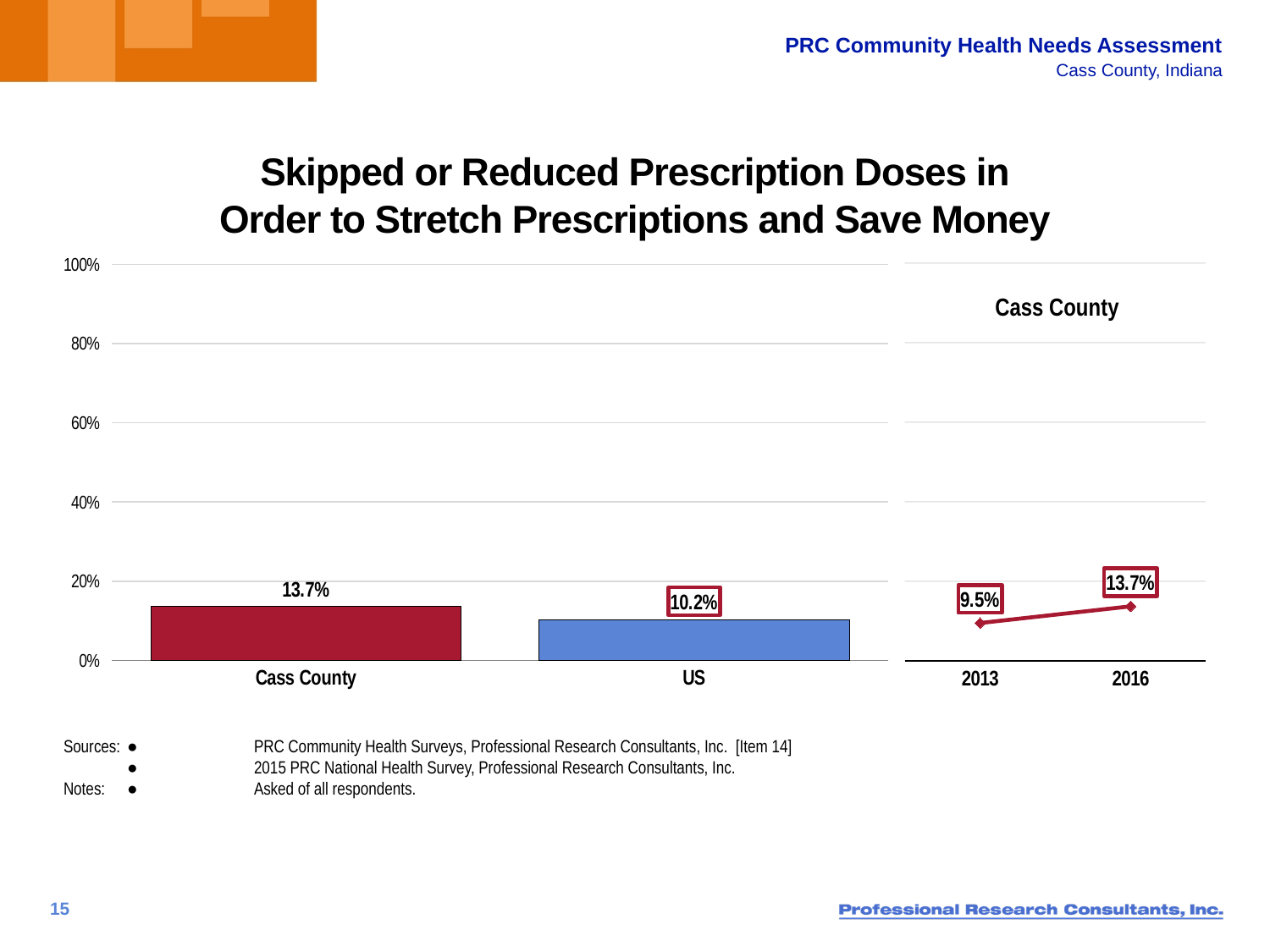
In the Cass County trend chart on the right, what is the value for 2013? 9.5% In the bar chart on the left, which category has the higher value, Cass County or US? Cass County In the bar chart on the left, what is the difference between the Cass County value and the US value? 3.5% In the Cass County trend chart on the right, what is the difference between the 2016 value and the 2013 value? 4.2% In the bar chart on the left, is the value for US greater or less than 20%? less What is the title of the chart on the slide? Skipped or Reduced Prescription Doses in Order to Stretch Prescriptions and Save Money In the Cass County trend chart on the right, what is the value for 2016? 13.7% How many categories are shown in the bar chart on the left? 2 In the Cass County trend chart on the right, do the values rise or fall from 2013 to 2016? rise In the bar chart on the left, what is the value for Cass County? 13.7% In the bar chart on the left, what is the value for US? 10.2% What kind of chart is the chart on the left? bar chart